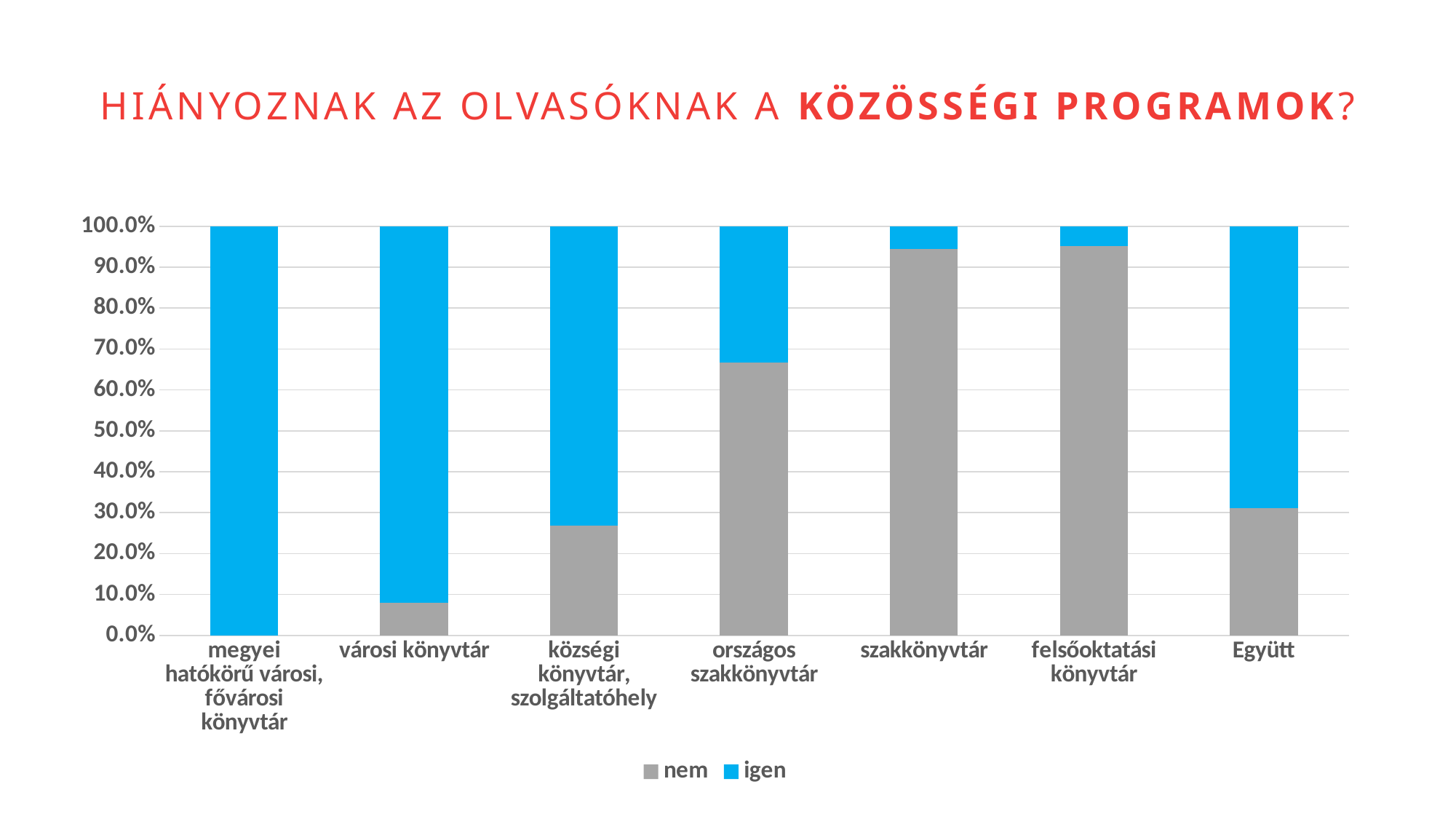
Which category has the lowest 'nem' share in the chart? megyei hatókörű városi, fővárosi könyvtár How many library categories are shown on the x axis of the chart? 7 Is the 'nem' share for szakkönyvtár greater or less than 80.0%? greater Is the 'nem' share for Együtt greater or less than 40.0%? less Which category has the highest 'igen' share in the chart? megyei hatókörű városi, fővárosi könyvtár Is the 'nem' share for városi könyvtár greater or less than 20.0%? less How many series does the chart legend list? 2 Which series is shown in grey in the chart? nem Which has the larger 'nem' share: országos szakkönyvtár or községi könyvtár, szolgáltatóhely? országos szakkönyvtár What kind of chart is shown on the slide? stacked bar chart Which has the larger 'igen' share: Együtt or felsőoktatási könyvtár? Együtt